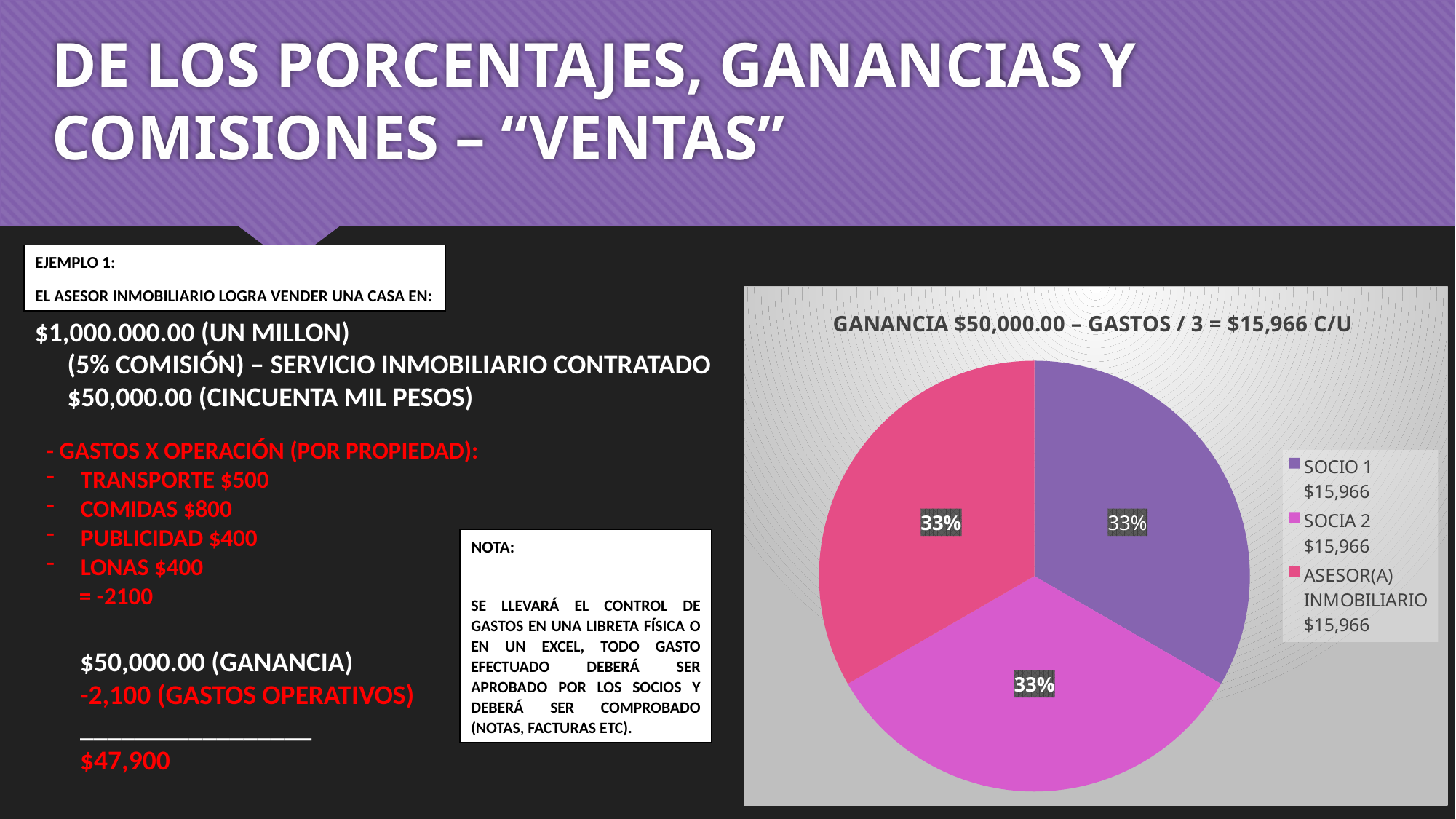
What share of the pie does ASESOR(A) INMOBILIARIO represent? 33% What share of the pie does SOCIA 2 represent? 33% What kind of chart is shown on the slide? pie chart What amount does the legend show for SOCIO 1? $15,966 What is the title of the pie chart? GANANCIA $50,000.00 – GASTOS / 3 = $15,966 C/U What amount does the legend show for ASESOR(A) INMOBILIARIO? $15,966 How many slices does the pie chart have? 3 What share of the pie does SOCIO 1 represent? 33% Which legend entry is shown in the red/pink colour on the pie chart? ASESOR(A) INMOBILIARIO What amount does the legend show for SOCIA 2? $15,966 How many entries does the legend of the pie chart list? 3